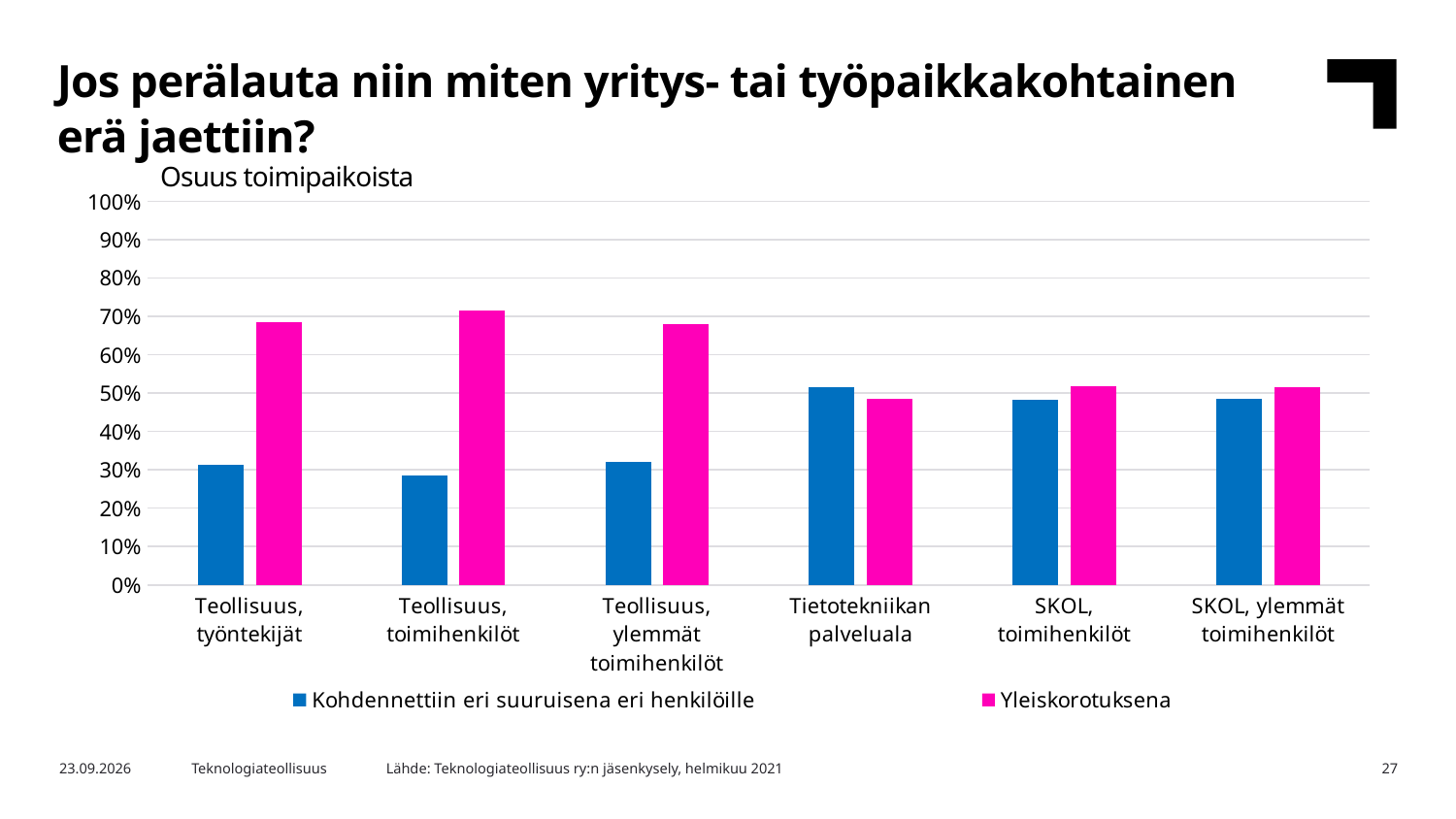
How many series does the legend list? 2 For Teollisuus, työntekijät, which series has the larger value: Kohdennettiin eri suuruisena eri henkilöille or Yleiskorotuksena? Yleiskorotuksena Is the Yleiskorotuksena value for SKOL, ylemmät toimihenkilöt greater or less than 60%? less Which series is shown in pink in the chart? Yleiskorotuksena Which category has the highest value for the Yleiskorotuksena series? Teollisuus, toimihenkilöt Which category has the lowest value for the Kohdennettiin eri suuruisena eri henkilöille series? Teollisuus, toimihenkilöt What is the title shown above the chart's y axis? Osuus toimipaikoista What kind of chart is shown on the slide? bar chart How many categories are shown on the x axis of the chart? 6 Is the Yleiskorotuksena value for Teollisuus, toimihenkilöt greater or less than 60%? greater Is the Kohdennettiin eri suuruisena eri henkilöille value for Tietotekniikan palveluala greater or less than 40%? greater